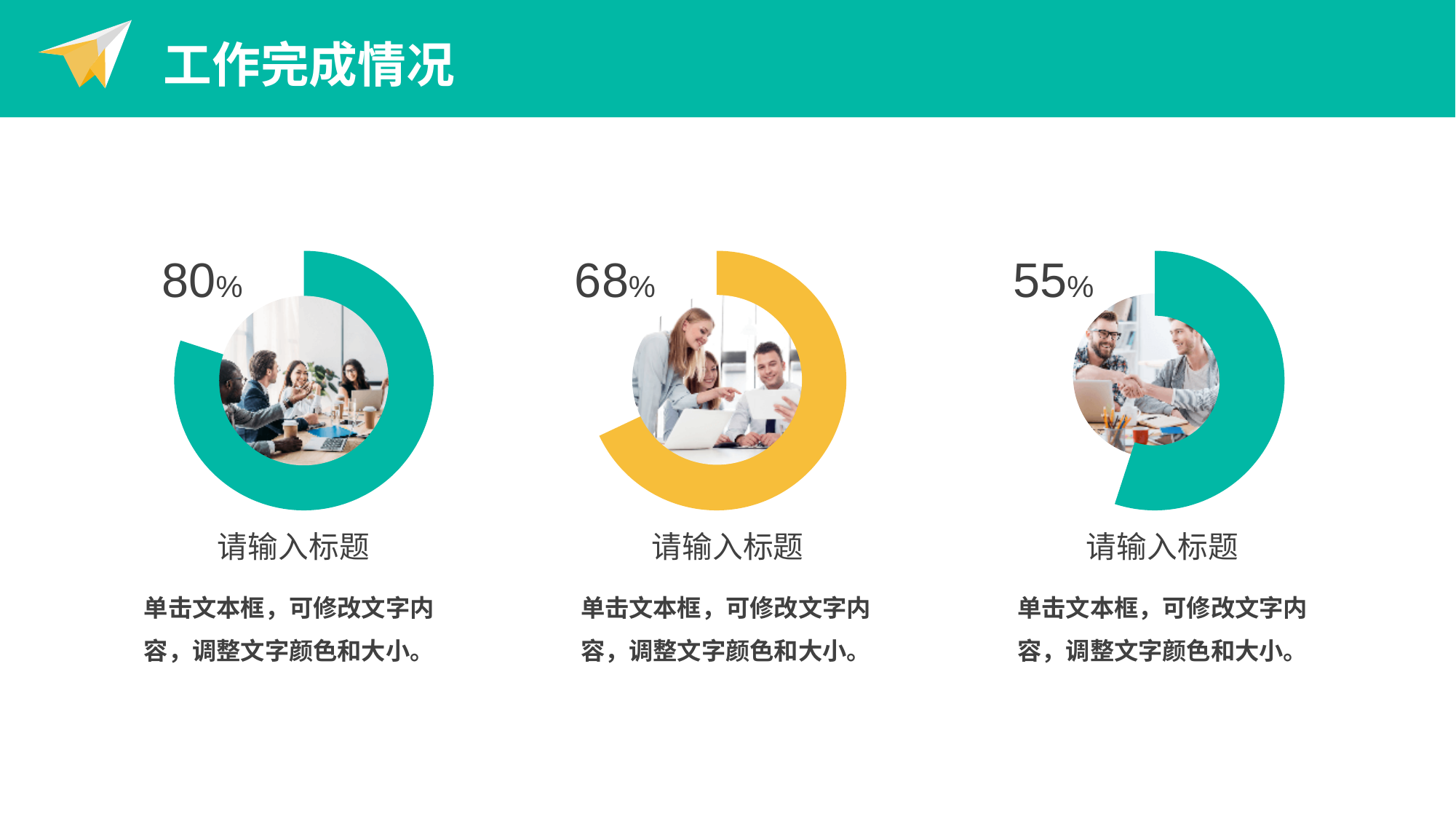
Which is larger, the value on the middle chart or the value on the right chart? The middle chart (68%) What is the difference between the value on the left chart and the value on the right chart? 25% How many ring charts are shown on the slide? 3 Which of the three charts shows the highest percentage? The left chart (80%) What kind of chart is used to show each percentage on the slide? Donut (ring) chart What value is shown on the middle chart? 68% What value is shown on the left chart? 80% What value is shown on the right chart? 55% What is the difference between the value on the left chart and the value on the middle chart? 12% What is the difference between the value on the middle chart and the value on the right chart? 13% Which of the three charts shows the lowest percentage? The right chart (55%) What colour is the ring of the middle chart? Yellow